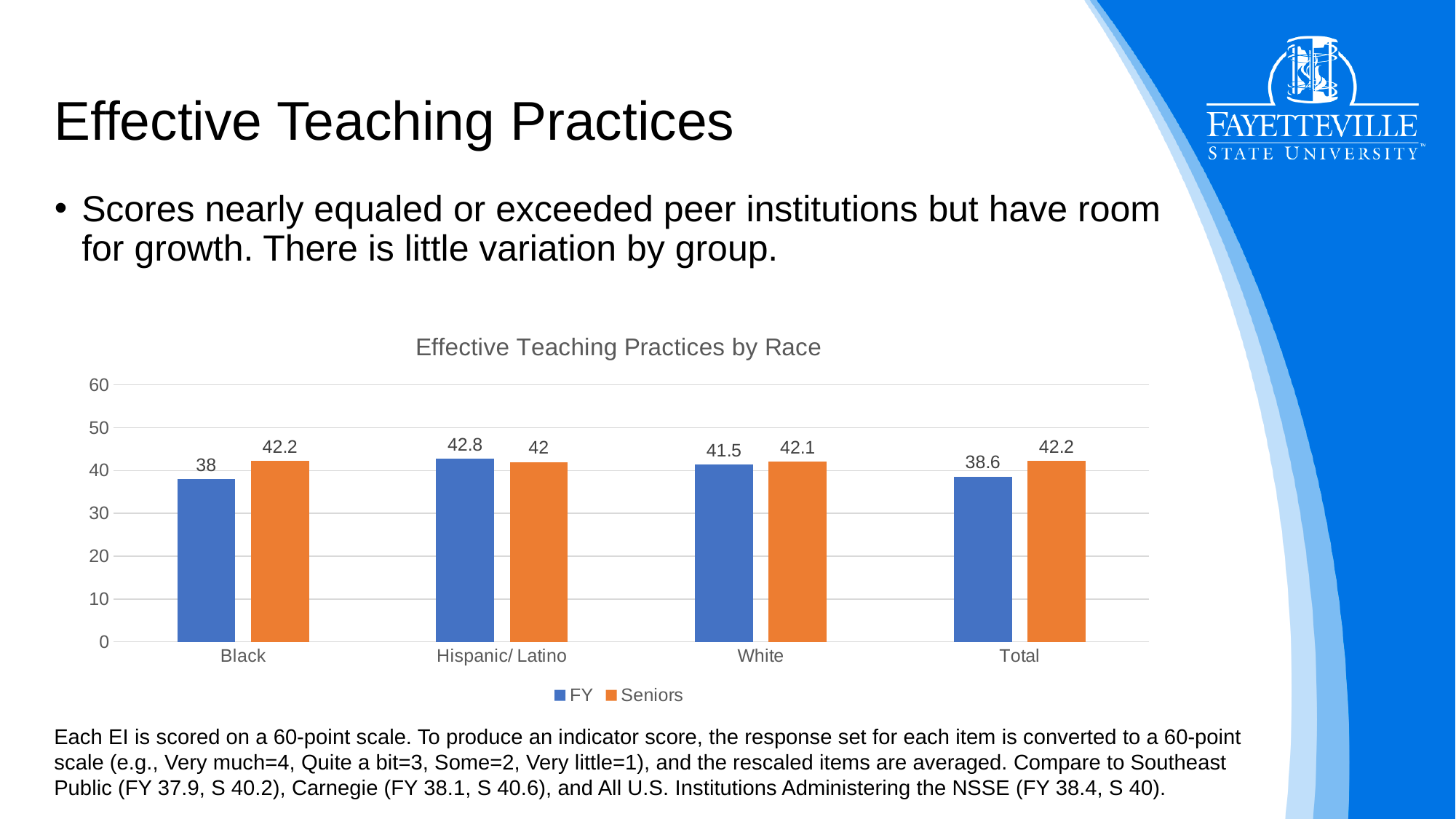
What is the FY value for Black in the Effective Teaching Practices by Race chart? 38 Which is larger for Hispanic/ Latino, the FY value or the Seniors value? FY How many series does the legend list? 2 What kind of chart is shown on the slide? Bar chart Which category has the highest FY value? Hispanic/ Latino What is the Seniors value for Total? 42.2 Which category has the lowest FY value? Black What is the Seniors value for Hispanic/ Latino? 42 What is the difference between the Seniors and FY values for Black? 4.2 What is the FY value for White? 41.5 What is the title of the chart? Effective Teaching Practices by Race How many categories are shown on the x axis? 4